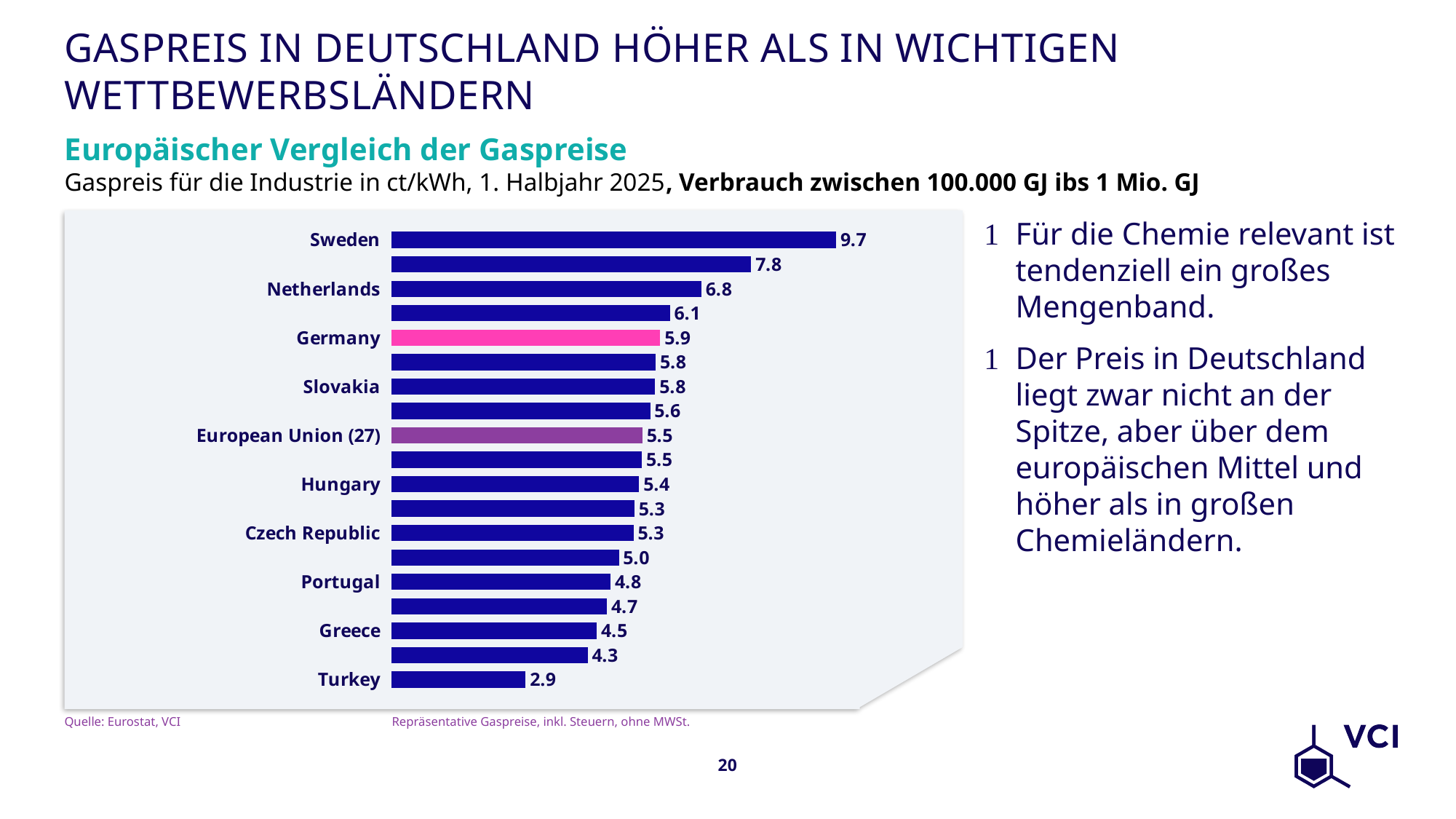
How much higher is the gas price for Germany than for European Union (27)? 0.4 Which has a higher gas price, Netherlands or Germany? Netherlands What is the gas price for Turkey? 2.9 What colour is the bar for Germany? Pink What is the value shown for Netherlands? 6.8 What kind of chart is shown on the slide? Bar chart Which country has the highest gas price in the chart? Sweden What is the difference between the gas price for Sweden and for Turkey? 6.8 What is the gas price for Sweden? 9.7 What is the value shown for European Union (27)? 5.5 What is the gas price for Germany? 5.9 Which country has the lowest gas price in the chart? Turkey